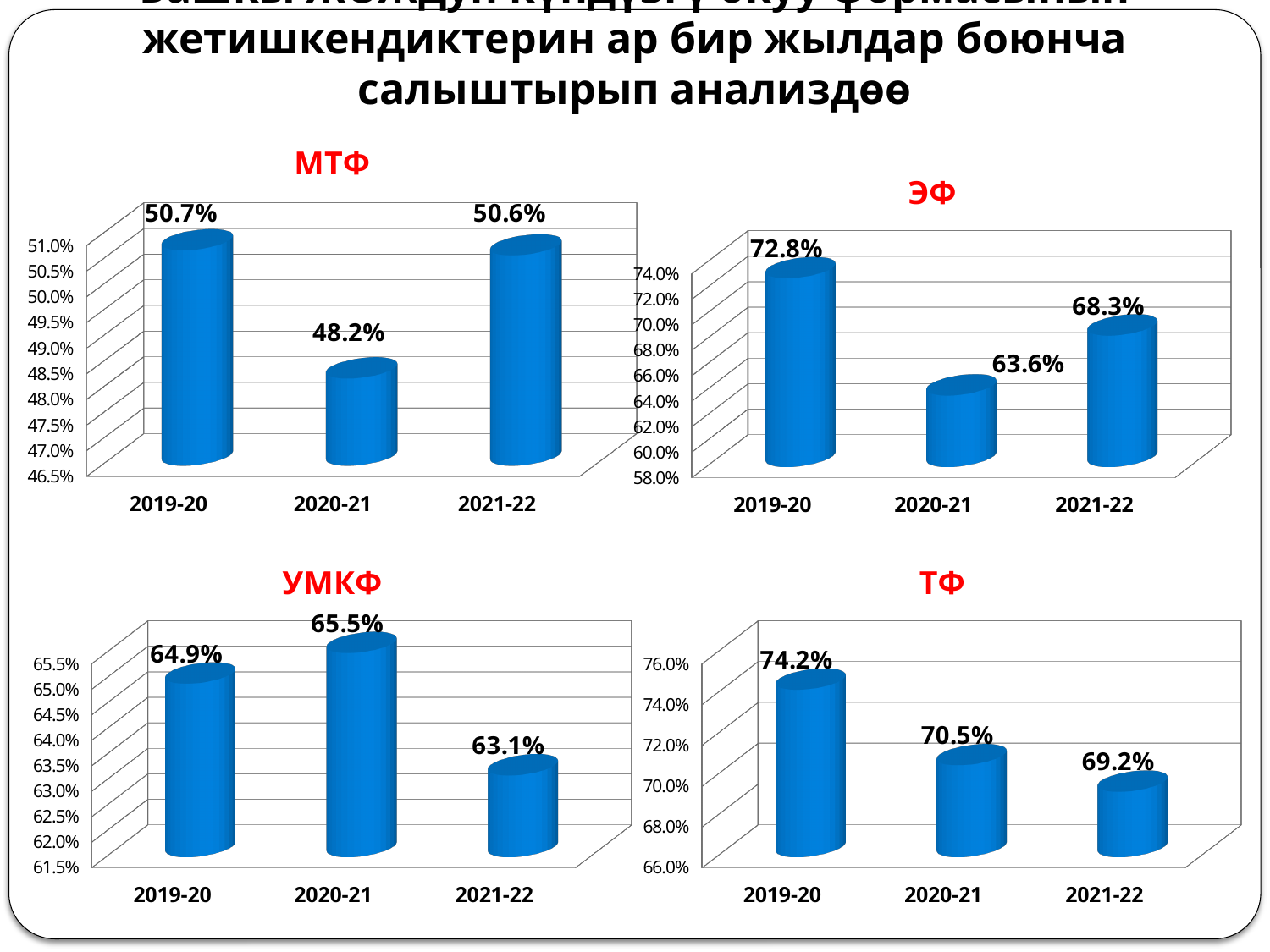
In the ТФ chart, do the values rise or fall from 2019-20 to 2021-22? fall What kind of chart is the ЭФ chart? bar chart In the ЭФ chart, what is the difference between the 2019-20 and 2020-21 values? 9.2% In the ЭФ chart, which year has the lowest value? 2020-21 In the МТФ chart, what is the value for 2020-21? 48.2% In the МТФ chart, what is the difference between the 2019-20 and 2021-22 values? 0.1% How many categories are shown on the x axis of the УМКФ chart? 3 In the УМКФ chart, which year has the highest value? 2020-21 In the ЭФ chart, what is the value for 2019-20? 72.8% In the ТФ chart, what is the value for 2020-21? 70.5% In the ТФ chart, which year has the highest value? 2019-20 In the УМКФ chart, what is the value for 2021-22? 63.1%